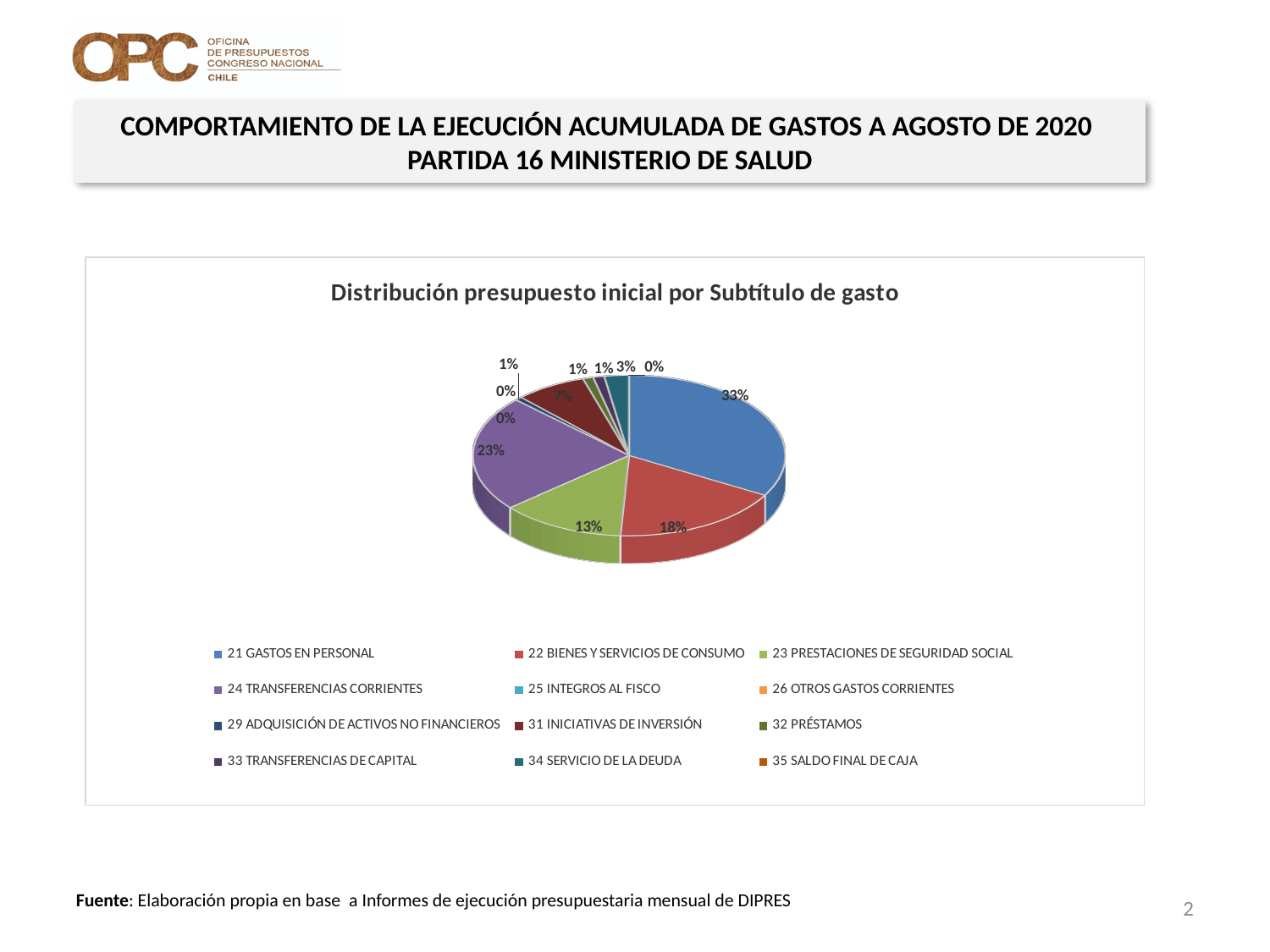
What is the value shown for 23 PRESTACIONES DE SEGURIDAD SOCIAL? 13% What is the value shown for 34 SERVICIO DE LA DEUDA? 3% What is the value shown for 31 INICIATIVAS DE INVERSIÓN? 7% What share of the pie does 21 GASTOS EN PERSONAL represent? 33% What is the title of the chart? Distribución presupuesto inicial por Subtítulo de gasto Which is larger: the share for 24 TRANSFERENCIAS CORRIENTES or for 22 BIENES Y SERVICIOS DE CONSUMO? 24 TRANSFERENCIAS CORRIENTES How many categories does the chart legend list? 12 What is the difference in percentage points between 21 GASTOS EN PERSONAL and 22 BIENES Y SERVICIOS DE CONSUMO? 15 percentage points Which category has the largest share of the pie? 21 GASTOS EN PERSONAL What kind of chart is shown on the slide? Pie chart What is the value shown for 24 TRANSFERENCIAS CORRIENTES? 23% What is the value shown for 22 BIENES Y SERVICIOS DE CONSUMO? 18%